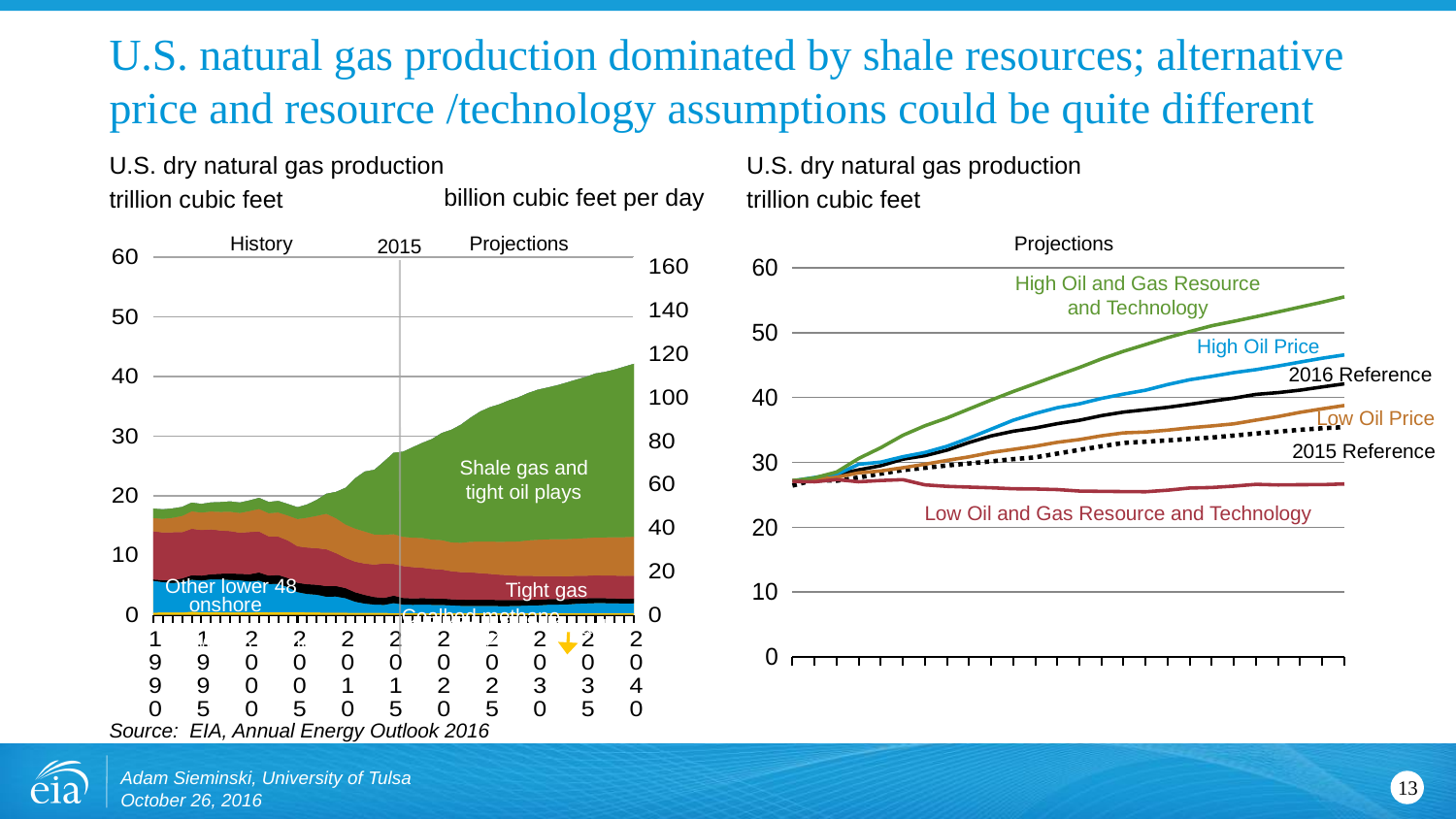
In the right chart, which scenario has the lowest production at the end of the projection period? Low Oil and Gas Resource and Technology In the left chart, which year marks the boundary between History and Projections? 2015 What kind of chart is the left chart, 'U.S. dry natural gas production' with History and Projections? Stacked area chart What kind of chart is the right chart showing the Projections scenarios? Line chart In the left chart, which source makes up the largest share of production in 2040? Shale gas and tight oil plays In the right chart, is the final value for the High Oil and Gas Resource and Technology scenario greater or less than 50? greater In the right chart, which ends higher at the end of the projection period, High Oil Price or 2016 Reference? High Oil Price In the left chart, is total dry natural gas production in 2040 greater or less than 40 trillion cubic feet? greater In the right chart, how many scenario lines are labeled? 6 In the right chart, which scenario has the highest production at the end of the projection period? High Oil and Gas Resource and Technology In the left chart, what unit is shown on the right-hand vertical axis? billion cubic feet per day In the left chart, does total production rise or fall over the projection period from 2015 to 2040? rise